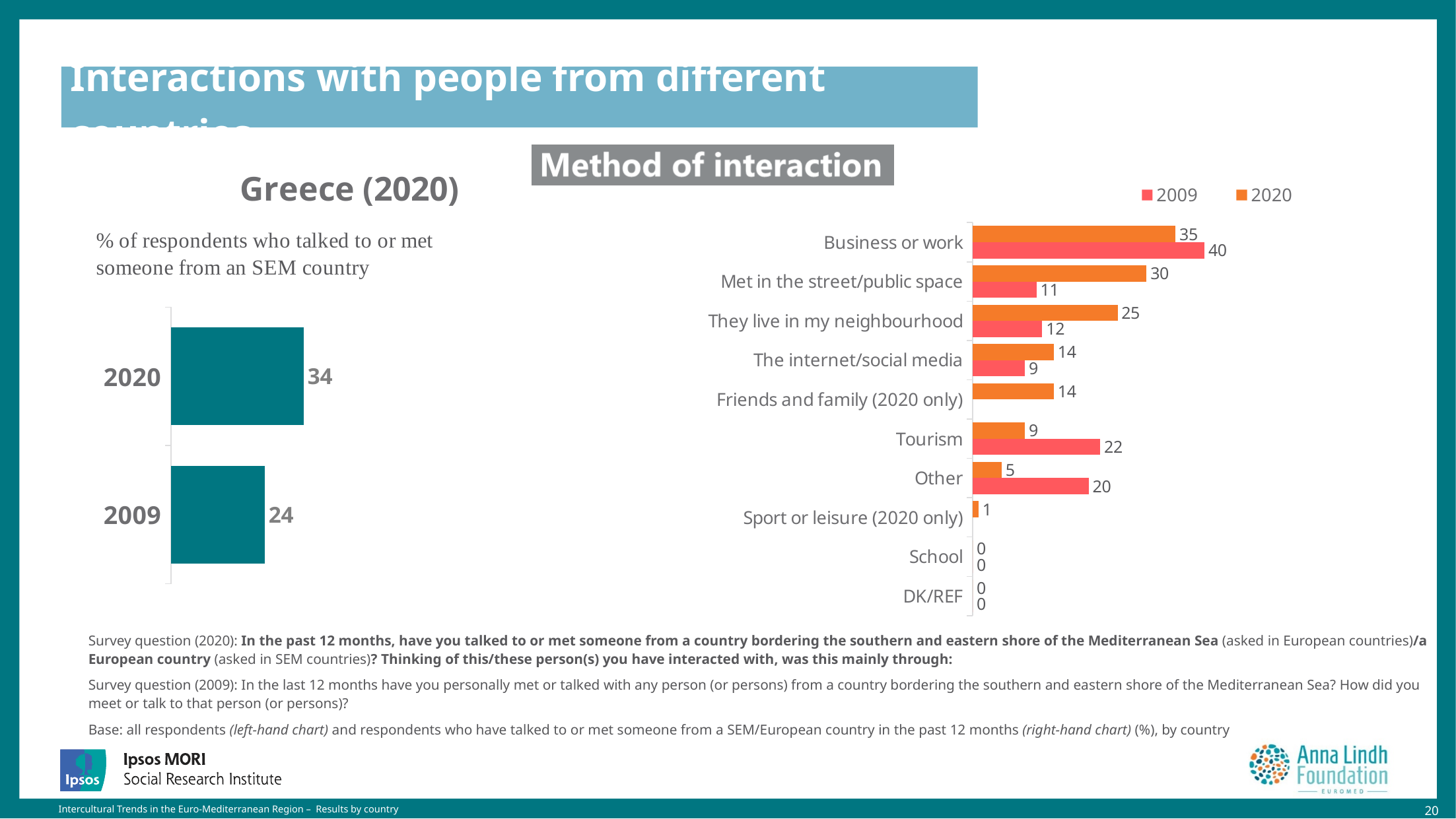
In the left-hand chart (Greece (2020)), what is the value for 2009? 24 In the Method of interaction chart, what is the 2020 value for Business or work? 35 In the Method of interaction chart, what is the difference between the 2020 and 2009 values for Other? 15 In the left-hand chart (Greece (2020)), what is the value for 2020? 34 In the Method of interaction chart, what is the 2009 value for Met in the street/public space? 11 What kind of chart is the left-hand chart (Greece (2020))? Bar chart In the Method of interaction chart, which category has the highest 2020 value? Business or work How many series does the legend of the Method of interaction chart list? 2 How many categories are shown in the Method of interaction chart? 10 In the Method of interaction chart, which is larger for They live in my neighbourhood: the 2009 value or the 2020 value? 2020 In the Method of interaction chart, what is the 2009 value for Tourism? 22 In the left-hand chart (Greece (2020)), what is the difference between the 2020 and 2009 values? 10